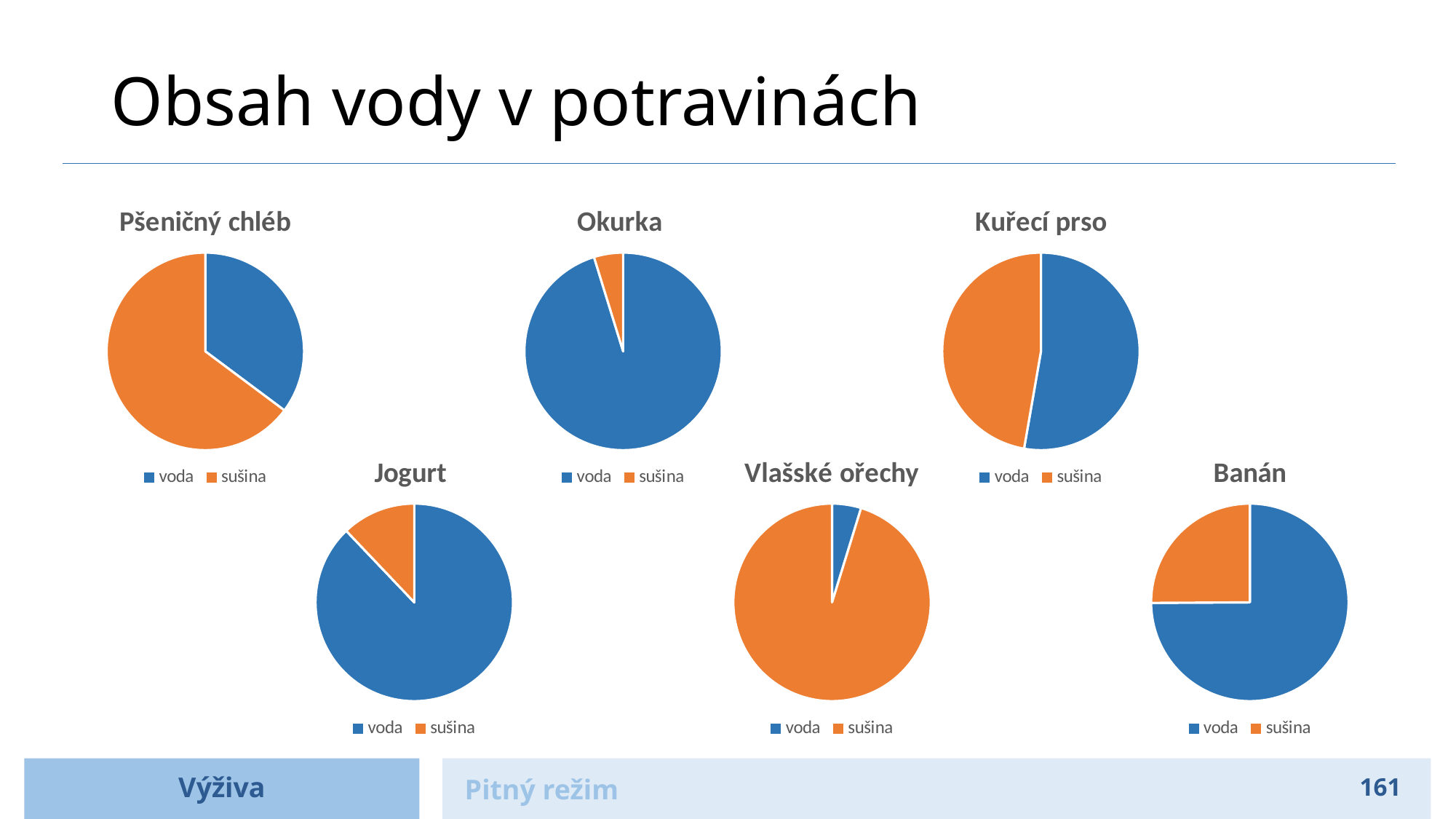
In the "Okurka" chart, which slice is larger, voda or sušina? voda How many slices does the "Pšeničný chléb" pie chart have? 2 In the "Pšeničný chléb" chart, which slice is larger, voda or sušina? sušina In the "Vlašské ořechy" chart, which slice is larger, voda or sušina? sušina How many series does the legend of the "Banán" chart list? 2 What colour represents "sušina" in the pie charts? orange What kind of chart is used for "Okurka"? pie chart Across the six pie charts, which food has the largest voda slice? Okurka How many pie charts are shown on the slide? 6 Across the six pie charts, which food has the smallest voda slice? Vlašské ořechy